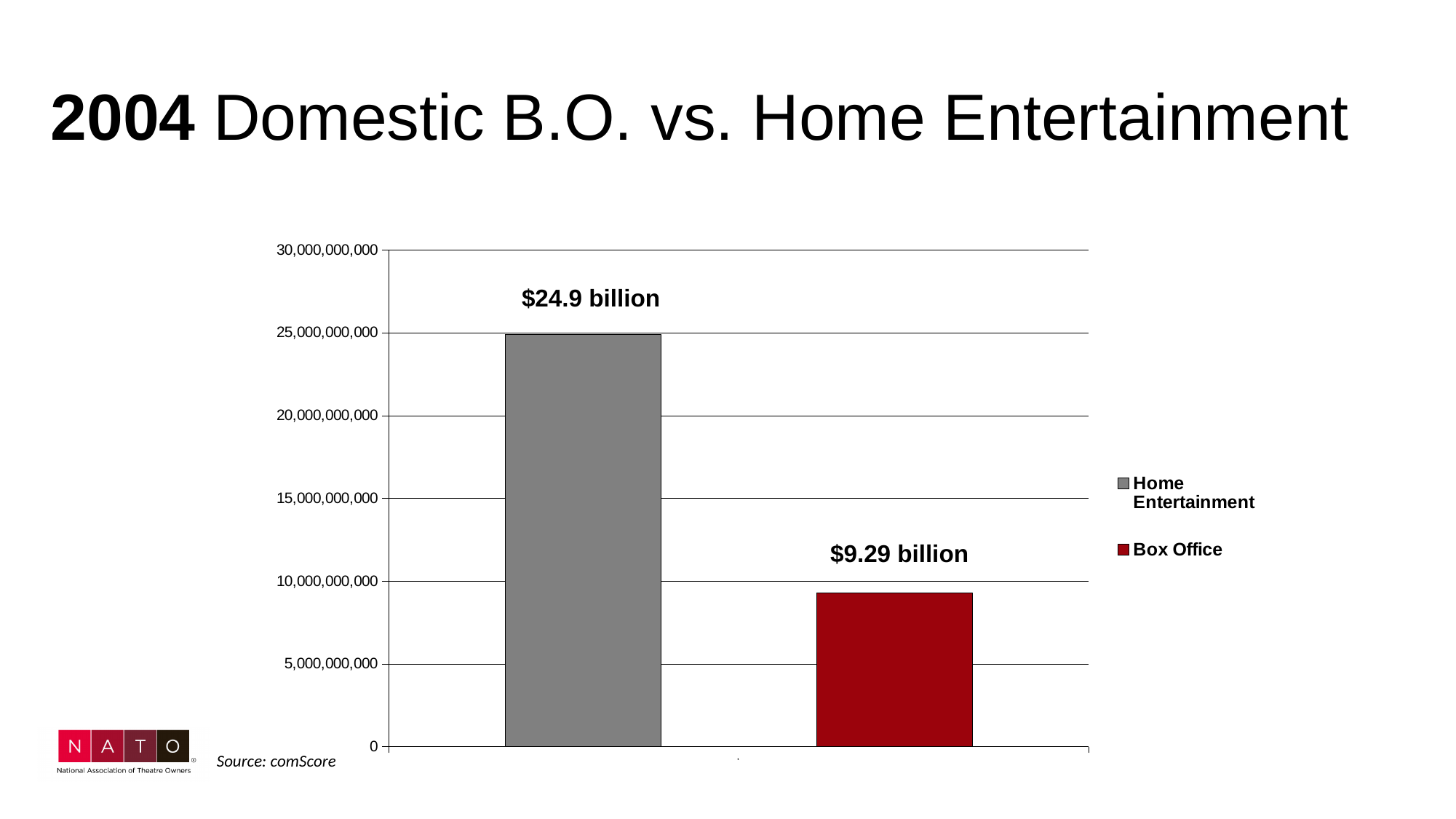
What kind of chart is shown on the slide? bar chart How many bars are plotted on the chart? 2 What is the value shown for Box Office? $9.29 billion What is the value shown for Home Entertainment? $24.9 billion What is the title of the slide? 2004 Domestic B.O. vs. Home Entertainment How many series does the legend list? 2 Which series has the lower value? Box Office Which series has the higher value, Home Entertainment or Box Office? Home Entertainment Is the Home Entertainment value greater or less than 20,000,000,000? greater What colour is the Box Office bar? dark red Is the Box Office value greater or less than 10,000,000,000? less Is the Box Office bar larger or smaller than the Home Entertainment bar? smaller